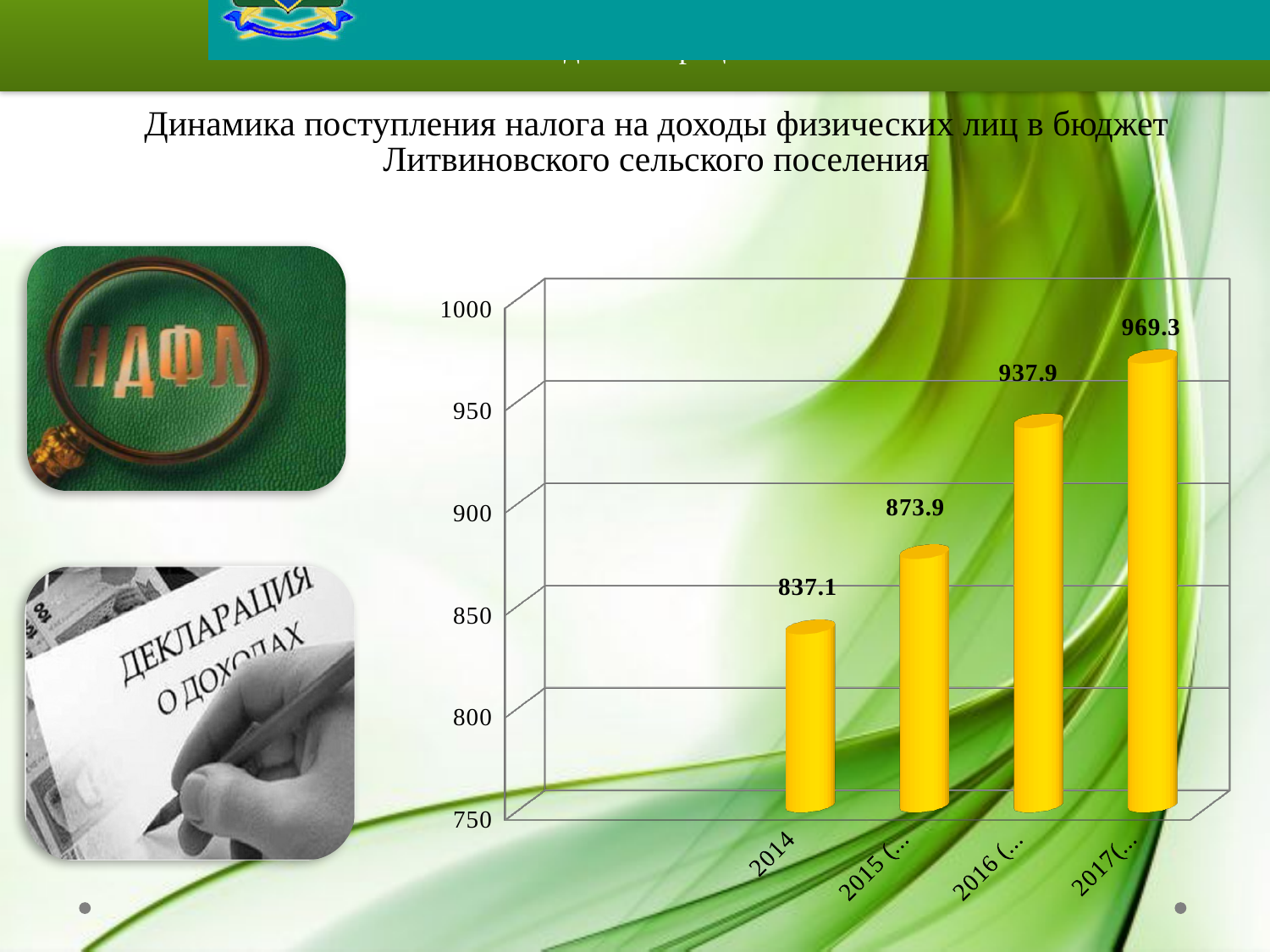
Do the values rise or fall from 2014 to 2017? rise What is the value for 2017? 969.3 What is the value for 2016? 937.9 What is the difference between the values for 2016 and 2015? 64 Which year has the highest value? 2017 What is the value for 2015? 873.9 Which is larger, the value for 2015 or the value for 2016? 2016 What kind of chart is shown on the slide? bar chart What is the difference between the values for 2017 and 2014? 132.2 Which year has the lowest value? 2014 What is the value for 2014? 837.1 How many bars are shown in the chart? 4